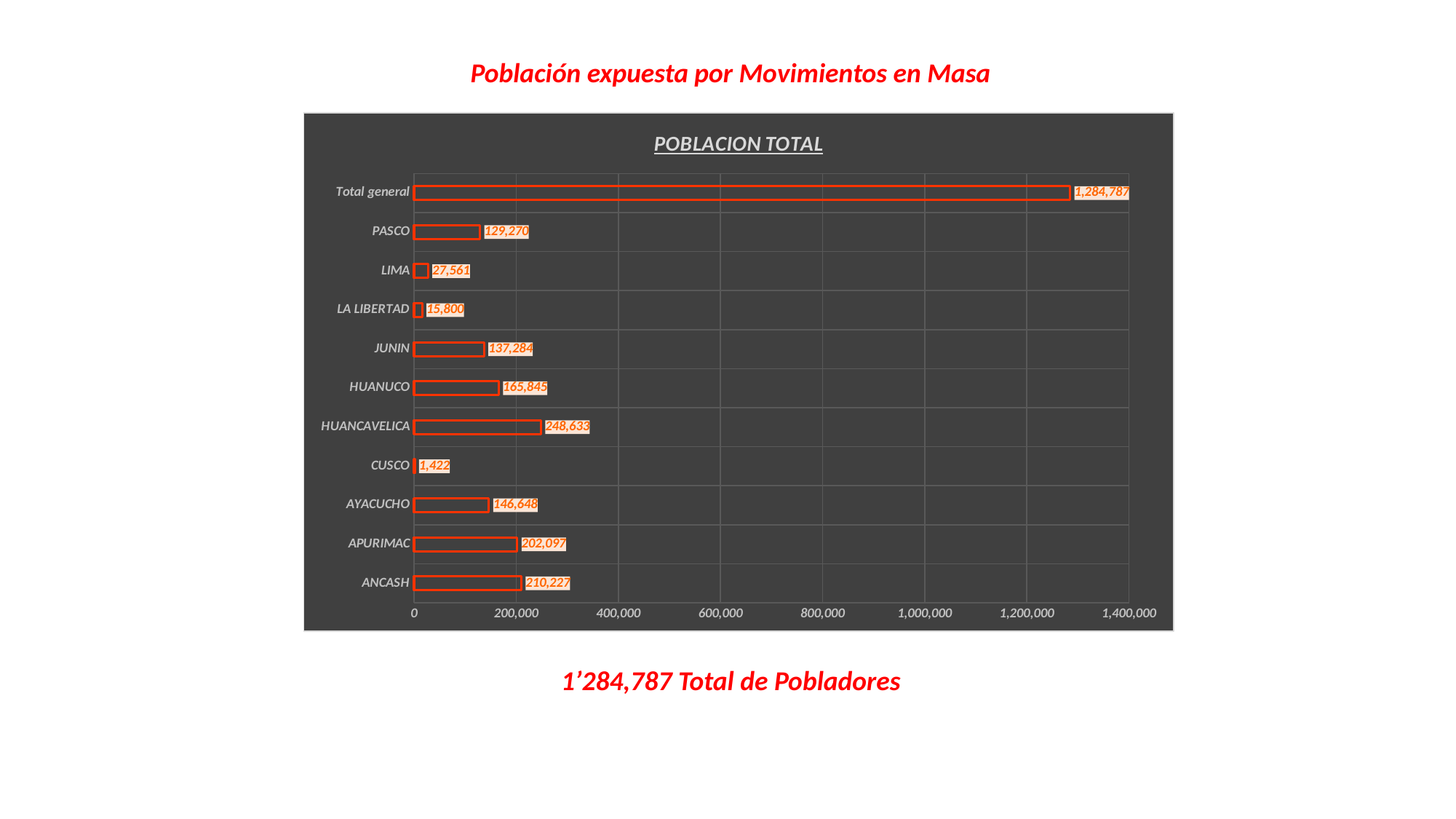
How many bars are shown in the chart, including Total general? 11 Which is larger, the value for JUNIN or the value for PASCO? JUNIN What is the value for CUSCO? 1,422 Is the value for HUANUCO greater or less than 200,000? less What is the difference between the values for ANCASH and APURIMAC? 8,130 What is the value for LA LIBERTAD? 15,800 What is the value for HUANCAVELICA? 248,633 Which region has the lowest value? CUSCO What is the value for Total general? 1,284,787 What is the title of the chart? POBLACION TOTAL What kind of chart is shown? bar chart Excluding Total general, which region has the highest value? HUANCAVELICA